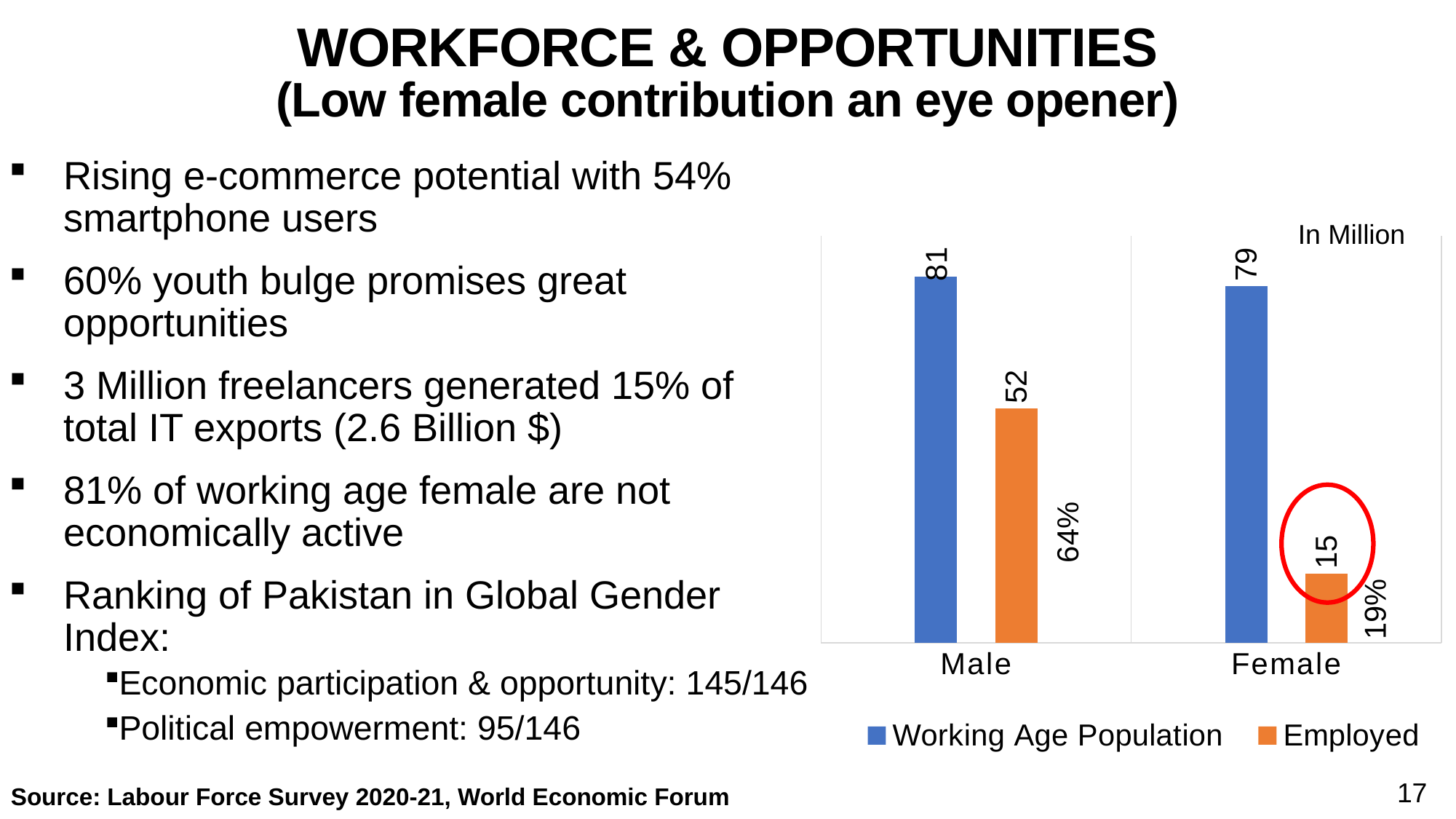
What is the difference between the Working Age Population and Employed values for Female? 64 What is the Employed value for Male? 52 What is the Working Age Population value for Female? 79 Which category has the lower Employed value, Male or Female? Female What percentage label is shown next to the Employed bar for Male? 64% What percentage label is shown next to the Employed bar for Female? 19% How many series does the legend list? 2 What kind of chart is shown on the slide? Bar chart What is the Working Age Population value for Male? 81 What unit is indicated at the top right of the chart? In Million What is the difference between the Employed values for Male and Female? 37 What is the Employed value for Female? 15